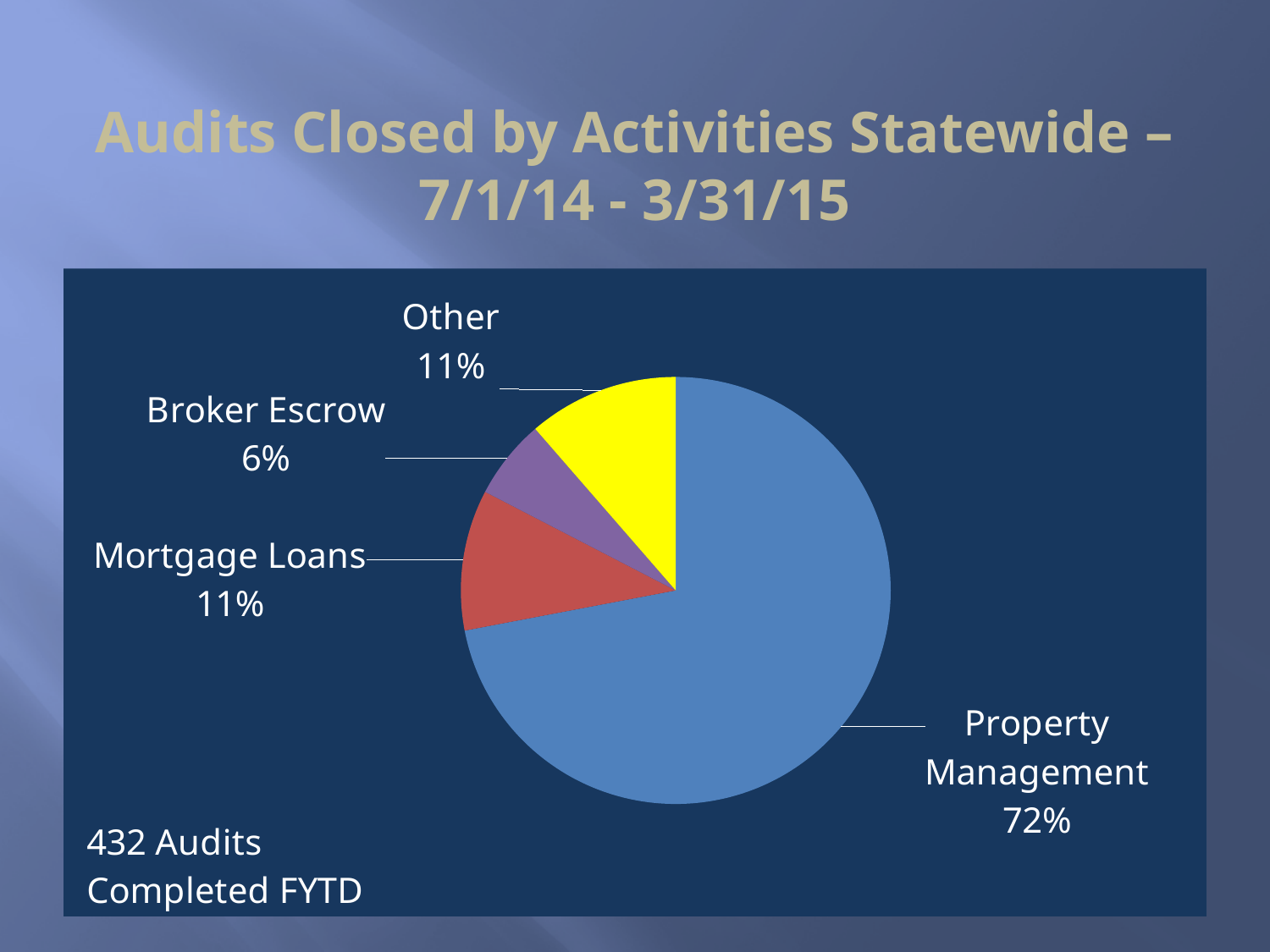
What is the difference in percentage points between Property Management and Mortgage Loans? 61 What share of audits closed is Property Management? 72% What share of audits closed is Mortgage Loans? 11% Which activity has the smallest share of audits closed? Broker Escrow Which is larger, the share for Mortgage Loans or the share for Broker Escrow? Mortgage Loans How many slices does the pie chart have? 4 What colour is the Other slice of the pie chart? yellow Which activity has the largest share of audits closed? Property Management How many audits were completed FYTD according to the slide? 432 What share of audits closed is Broker Escrow? 6% What kind of chart is shown on the slide? pie chart